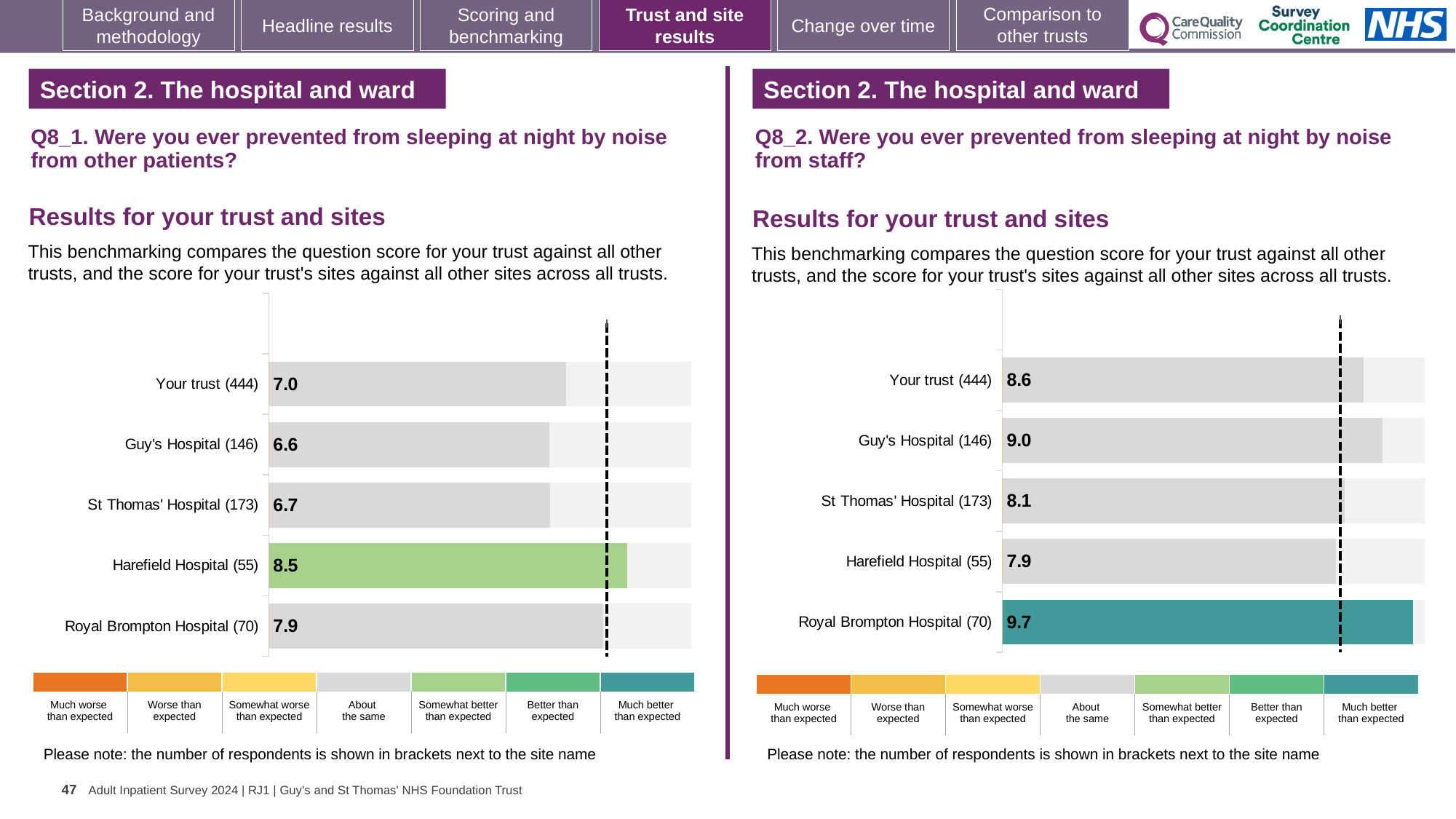
What type of chart is used for the Q8_2 results (noise from staff)? Bar chart In the Q8_2 chart (noise from staff), what is the difference between the scores for Royal Brompton Hospital and St Thomas' Hospital? 1.6 In the Q8_2 chart (noise from staff), which site has the lowest score? Harefield Hospital (55) In the Q8_1 chart (noise from other patients), what is the difference between the scores for Harefield Hospital and Your trust? 1.5 In the Q8_2 chart (noise from staff), what benchmark category does the colour of the Royal Brompton Hospital bar indicate? Much better than expected How many bars are plotted in the Q8_1 chart (noise from other patients)? 5 In the Q8_1 chart (noise from other patients), which has the larger score, Guy's Hospital or St Thomas' Hospital? St Thomas' Hospital In the Q8_1 chart (noise from other patients), which site has the lowest score? Guy's Hospital (146) In the Q8_2 chart (noise from staff), which has the larger score, Your trust or Guy's Hospital? Guy's Hospital In the Q8_1 chart (noise from other patients), which site has the highest score? Harefield Hospital (55) In the Q8_2 chart (noise from staff), what is the score for Royal Brompton Hospital (70)? 9.7 In the Q8_1 chart (noise from other patients), what is the score for Your trust (444)? 7.0